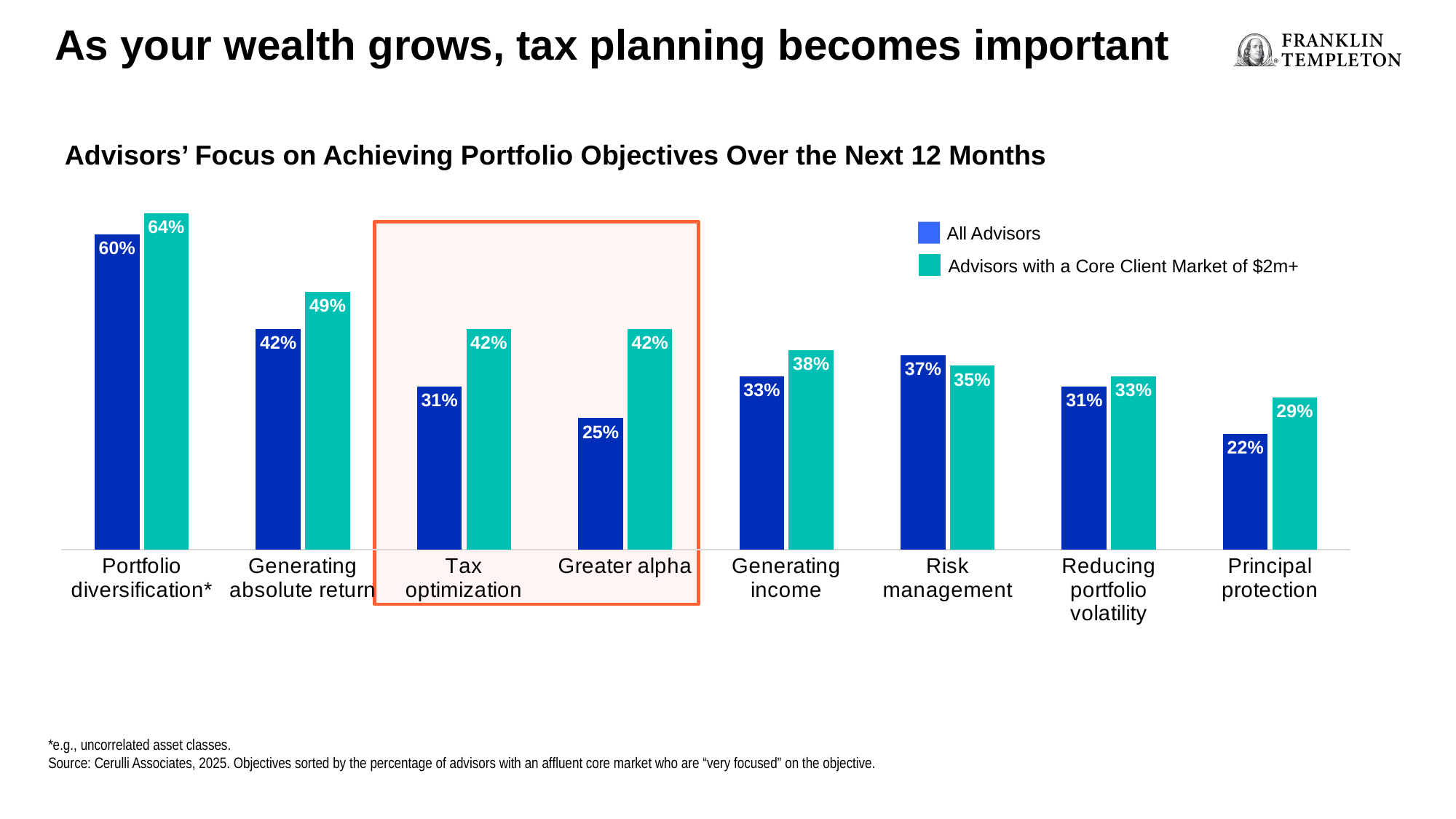
Which objective has the highest value for Advisors with a Core Client Market of $2m+? Portfolio diversification* For Risk management, which series has the larger value: All Advisors or Advisors with a Core Client Market of $2m+? All Advisors What is the value for Advisors with a Core Client Market of $2m+ for Greater alpha? 42% What is the difference between the two series for Greater alpha? 17% What is the value for All Advisors for Principal protection? 22% What percentage of All Advisors are focused on Tax optimization? 31% What kind of chart is shown on the slide? Bar chart How many series does the legend list? 2 Which two objectives are highlighted with an orange box? Tax optimization and Greater alpha Which objective has the lowest value for All Advisors? Principal protection What is the difference between Advisors with a Core Client Market of $2m+ and All Advisors for Tax optimization? 11% How many objectives are shown on the x axis? 8